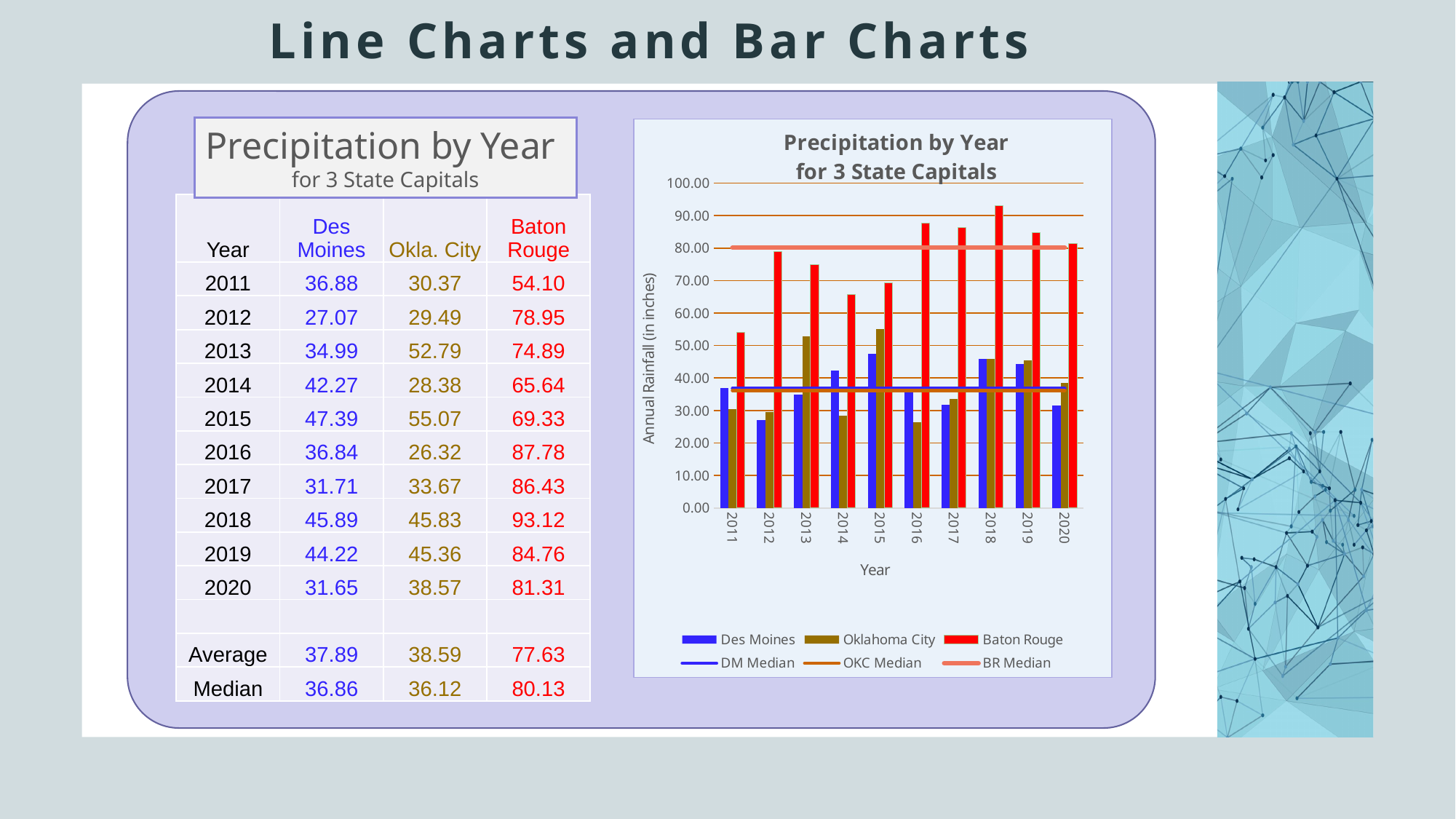
What is the title of the chart's vertical axis? Annual Rainfall (in inches) What kind of chart is shown on the slide? combination bar and line chart What is the Baton Rouge precipitation value for 2018? 93.12 Is the Baton Rouge value for 2011 greater or less than 60.00? less In which year is the Des Moines bar the lowest? 2012 In which year is the Baton Rouge bar the highest? 2018 How many years are plotted along the x axis of the chart? 10 In 2013, which is larger: the Oklahoma City bar or the Des Moines bar? Oklahoma City What is the difference between the Baton Rouge and Des Moines values in 2018? 47.23 Is the Baton Rouge value for 2016 greater or less than 80.00? greater How many series does the chart legend list? 6 What is the Des Moines precipitation value for 2015? 47.39